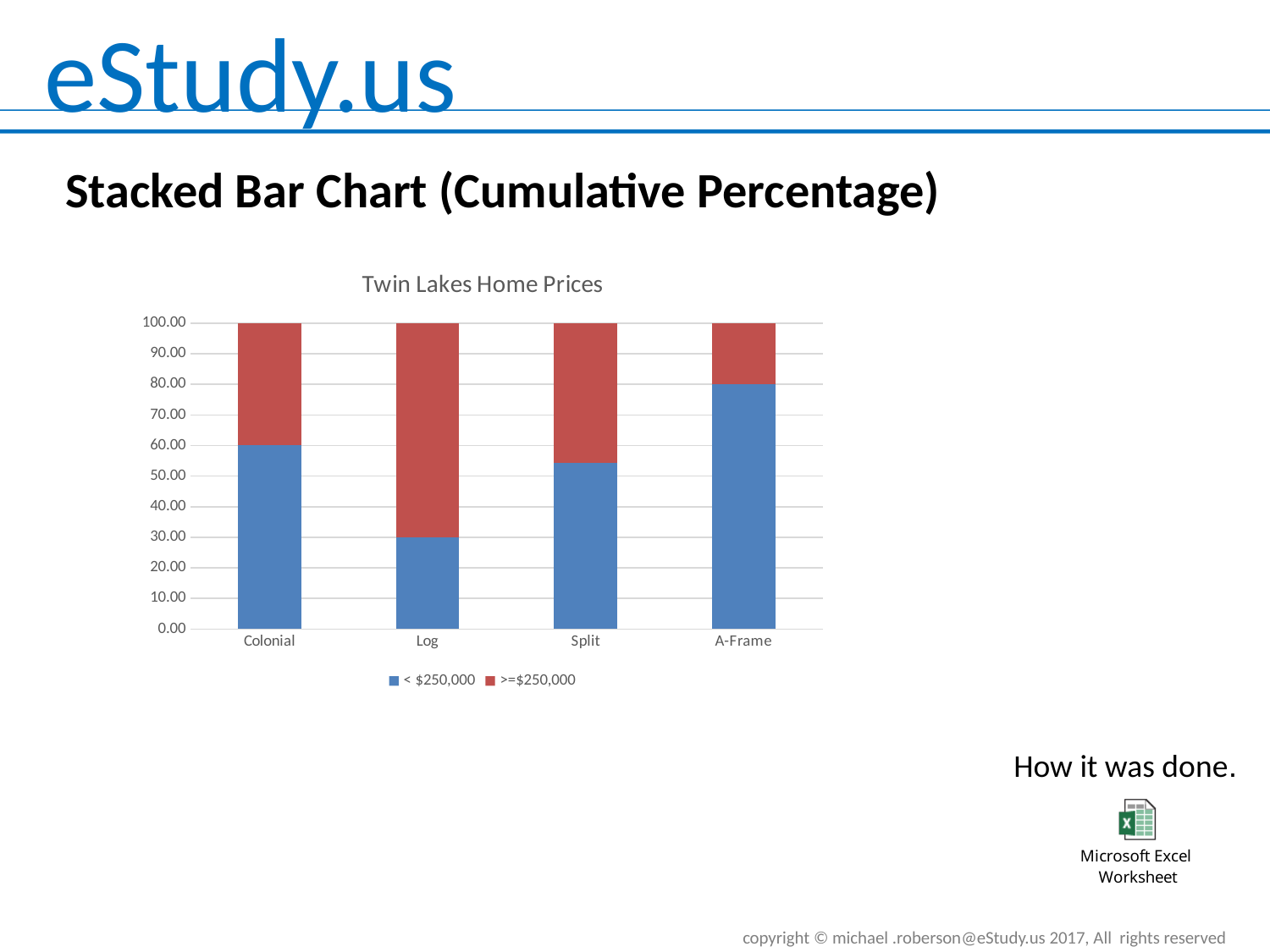
Which category has the largest >=$250,000 segment? Log Which category has the highest value for the < $250,000 series? A-Frame Which category has the lowest value for the < $250,000 series? Log How many series does the legend list? 2 What is the title of the chart? Twin Lakes Home Prices Is the < $250,000 value for Log greater or less than 40.00? less What type of chart is shown on the slide? stacked bar chart How many home-type categories are shown on the x axis? 4 Which series is shown in blue in the legend? < $250,000 Which is larger, the < $250,000 value for Colonial or for Log? Colonial Is the < $250,000 value for Split greater or less than 50.00? greater What is the total height of the stacked bar for Colonial? 100.00